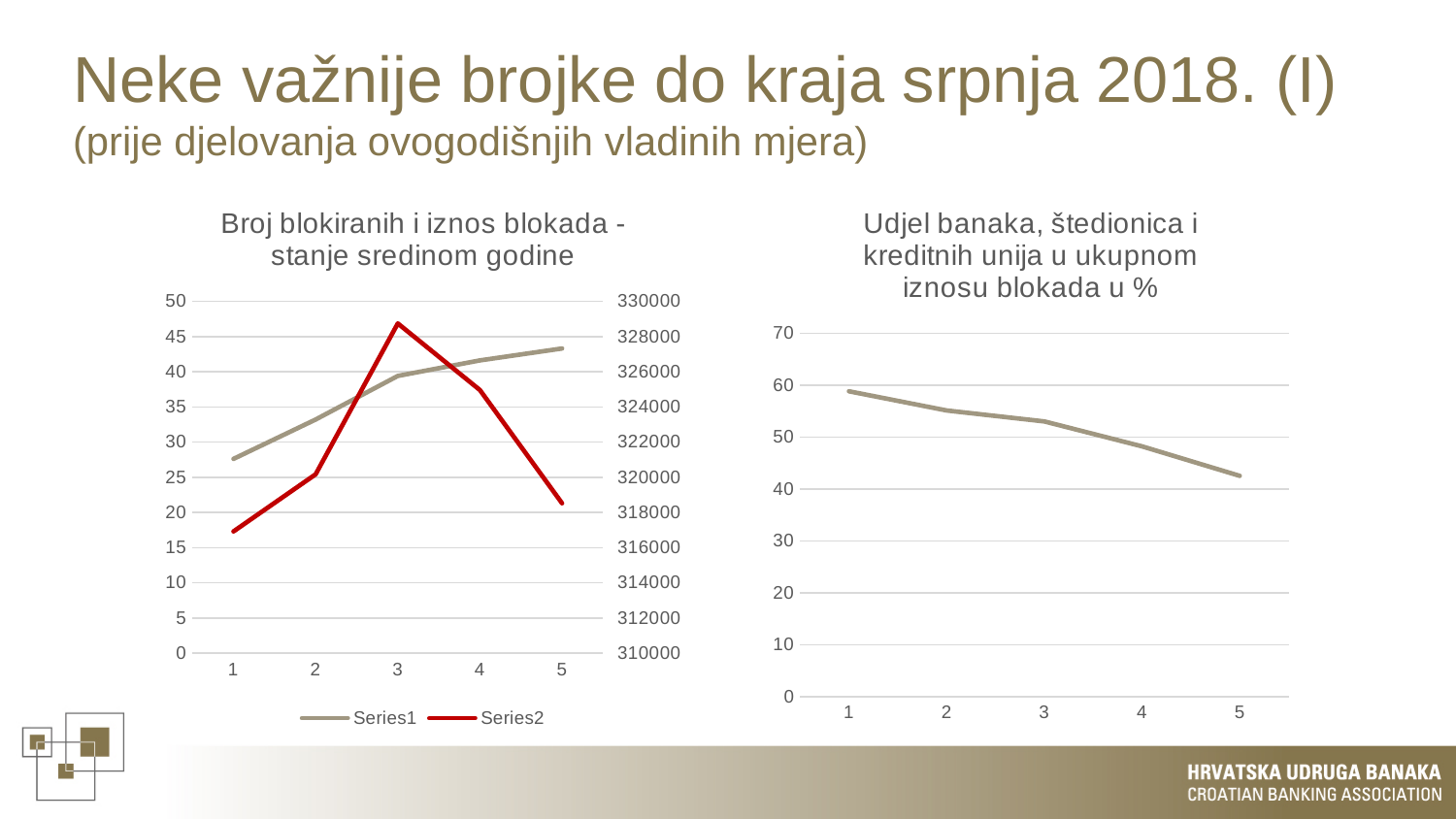
In the chart titled "Udjel banaka, štedionica i kreditnih unija u ukupnom iznosu blokada u %", at which category is the value highest? 1 In the chart titled "Broj blokiranih i iznos blokada - stanje sredinom godine", how many series does the legend list? 2 In the chart titled "Udjel banaka, štedionica i kreditnih unija u ukupnom iznosu blokada u %", is the value for category 1 greater or less than 50? greater In the chart titled "Broj blokiranih i iznos blokada - stanje sredinom godine", what colour is the Series2 line? red In the chart titled "Broj blokiranih i iznos blokada - stanje sredinom godine", at which category is Series2 lowest? 1 In the chart titled "Udjel banaka, štedionica i kreditnih unija u ukupnom iznosu blokada u %", is the value for category 5 greater or less than 50? less What kind of chart is the chart titled "Udjel banaka, štedionica i kreditnih unija u ukupnom iznosu blokada u %"? line chart In the chart titled "Udjel banaka, štedionica i kreditnih unija u ukupnom iznosu blokada u %", do the values rise or fall from category 1 to category 5? fall In the chart titled "Broj blokiranih i iznos blokada - stanje sredinom godine", do the values of Series1 rise or fall from category 1 to category 5? rise In the chart titled "Broj blokiranih i iznos blokada - stanje sredinom godine", at which category does Series2 reach its highest value? 3 In the chart titled "Broj blokiranih i iznos blokada - stanje sredinom godine", how many points are plotted along the x axis for each series? 5 In the chart titled "Udjel banaka, štedionica i kreditnih unija u ukupnom iznosu blokada u %", at which category is the value lowest? 5